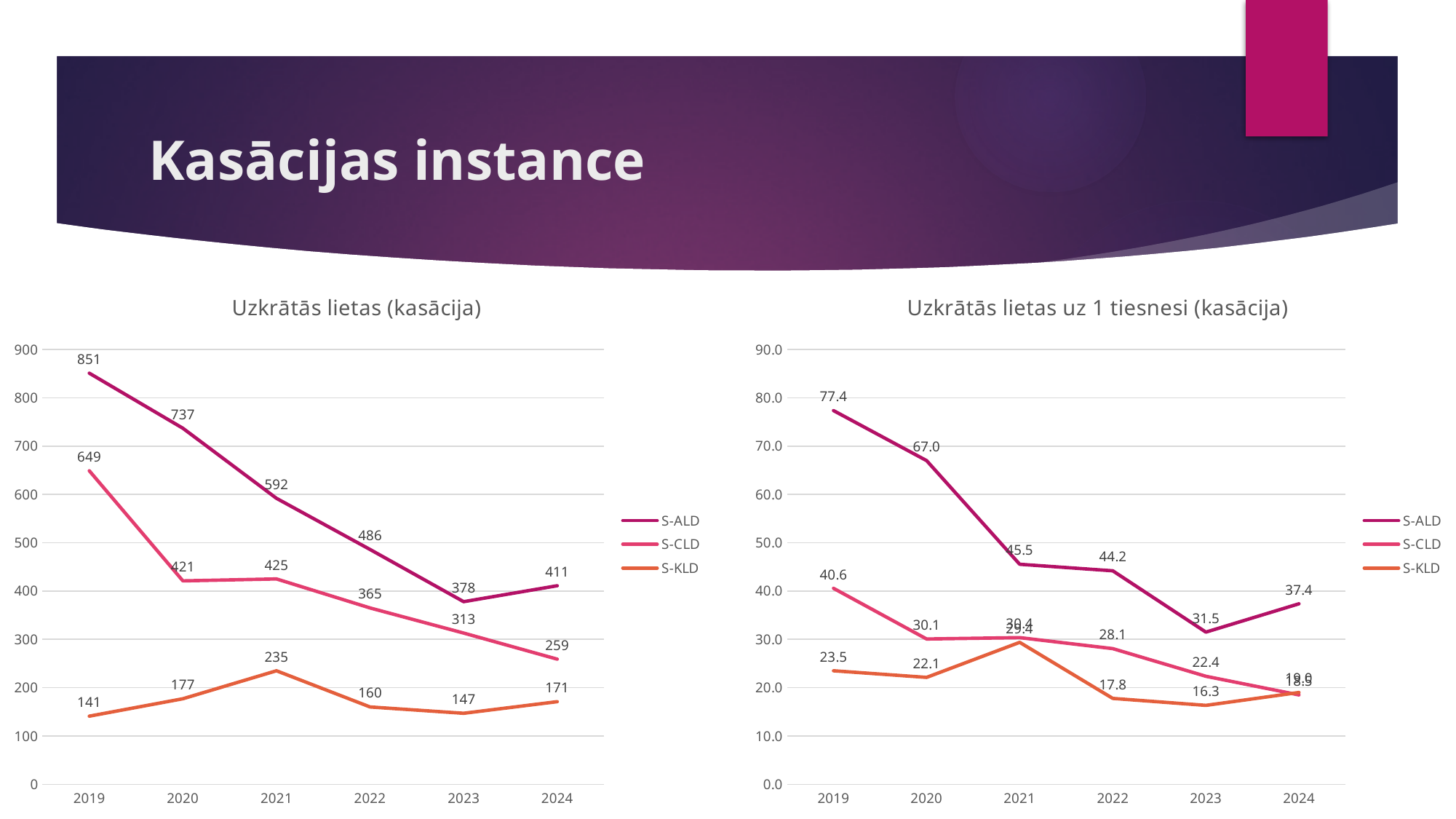
In the chart titled "Uzkrātās lietas uz 1 tiesnesi (kasācija)", in which year is the S-ALD value highest? 2019 In the chart titled "Uzkrātās lietas (kasācija)", in which year is the S-CLD value lowest? 2024 In the chart titled "Uzkrātās lietas (kasācija)", what is the value for S-KLD in 2021? 235 In the chart titled "Uzkrātās lietas uz 1 tiesnesi (kasācija)", what is the value for S-ALD in 2020? 67.0 In the chart titled "Uzkrātās lietas (kasācija)", what is the value for S-ALD in 2019? 851 In the chart titled "Uzkrātās lietas (kasācija)", what is the difference between the S-ALD values in 2019 and 2024? 440 In the chart titled "Uzkrātās lietas (kasācija)", how many series does the legend list? 3 In the chart titled "Uzkrātās lietas uz 1 tiesnesi (kasācija)", what is the value for S-KLD in 2023? 16.3 In the chart titled "Uzkrātās lietas (kasācija)", which series has the higher value in 2023, S-CLD or S-KLD? S-CLD What kind of chart is the chart titled "Uzkrātās lietas (kasācija)"? line chart In the chart titled "Uzkrātās lietas uz 1 tiesnesi (kasācija)", does the S-ALD value generally rise or fall from 2019 to 2023? fall In the chart titled "Uzkrātās lietas uz 1 tiesnesi (kasācija)", how many years are shown on the x axis? 6